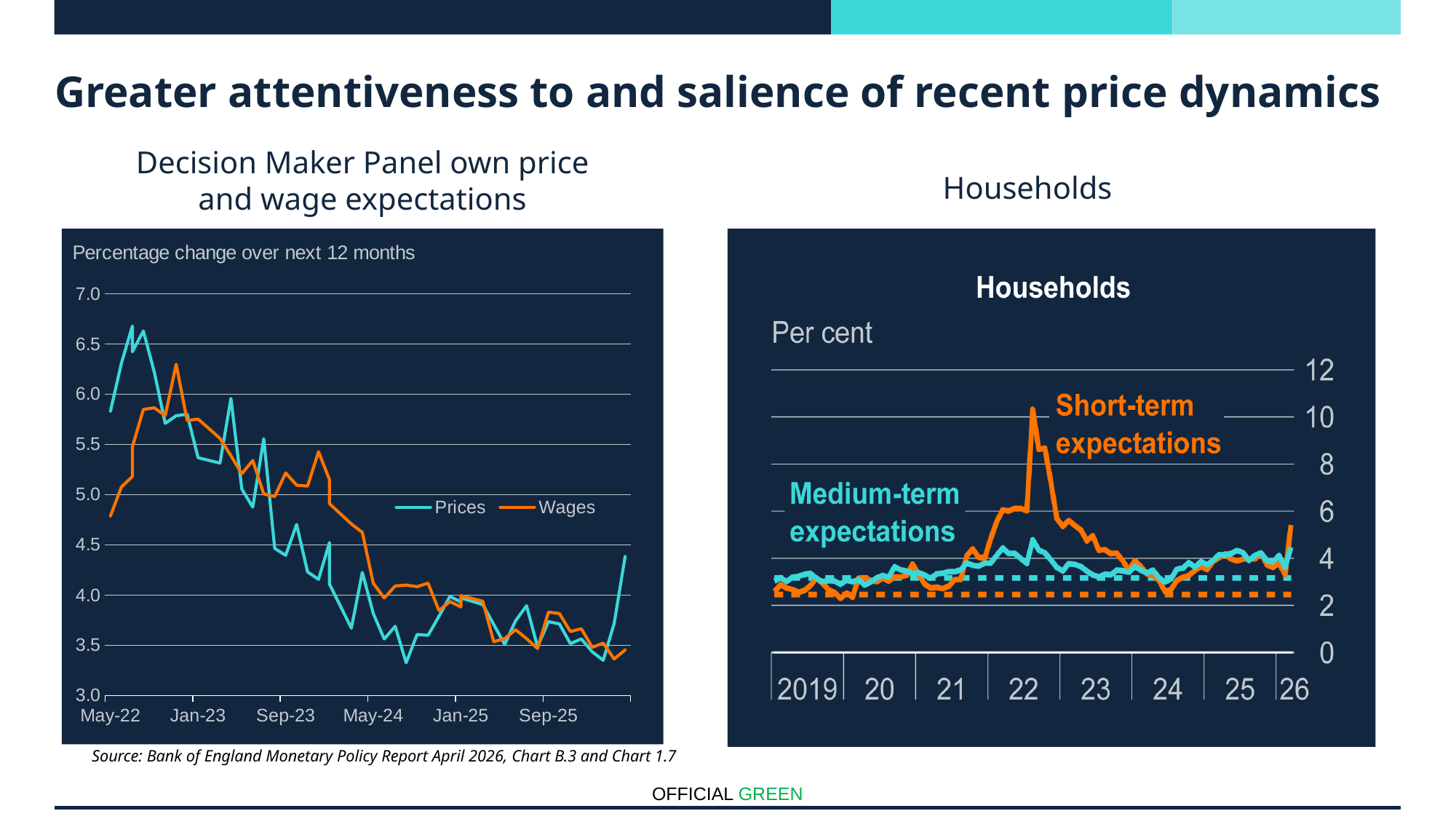
What kind of chart is the Households chart on the right? line chart In the Households chart on the right, what are the two series labelled? Short-term expectations and Medium-term expectations How many series does the legend of the left chart (Decision Maker Panel own price and wage expectations) list? 2 In the left chart (Decision Maker Panel own price and wage expectations), do the Prices and Wages series generally rise or fall between May-22 and Sep-25? fall In the Households chart on the right, is the peak of the Medium-term expectations series greater or less than 6 per cent? less What kind of chart is the Decision Maker Panel own price and wage expectations chart on the left? line chart In the Households chart on the right, which series reaches the higher peak, Short-term expectations or Medium-term expectations? Short-term expectations In the left chart (Decision Maker Panel own price and wage expectations), is the peak value of the Prices series greater or less than 6.5? greater In the Households chart on the right, is the peak of the Short-term expectations series greater or less than 8 per cent? greater What are the two series named in the legend of the left chart (Decision Maker Panel own price and wage expectations)? Prices and Wages In the left chart (Decision Maker Panel own price and wage expectations), which series reaches the higher peak, Prices or Wages? Prices